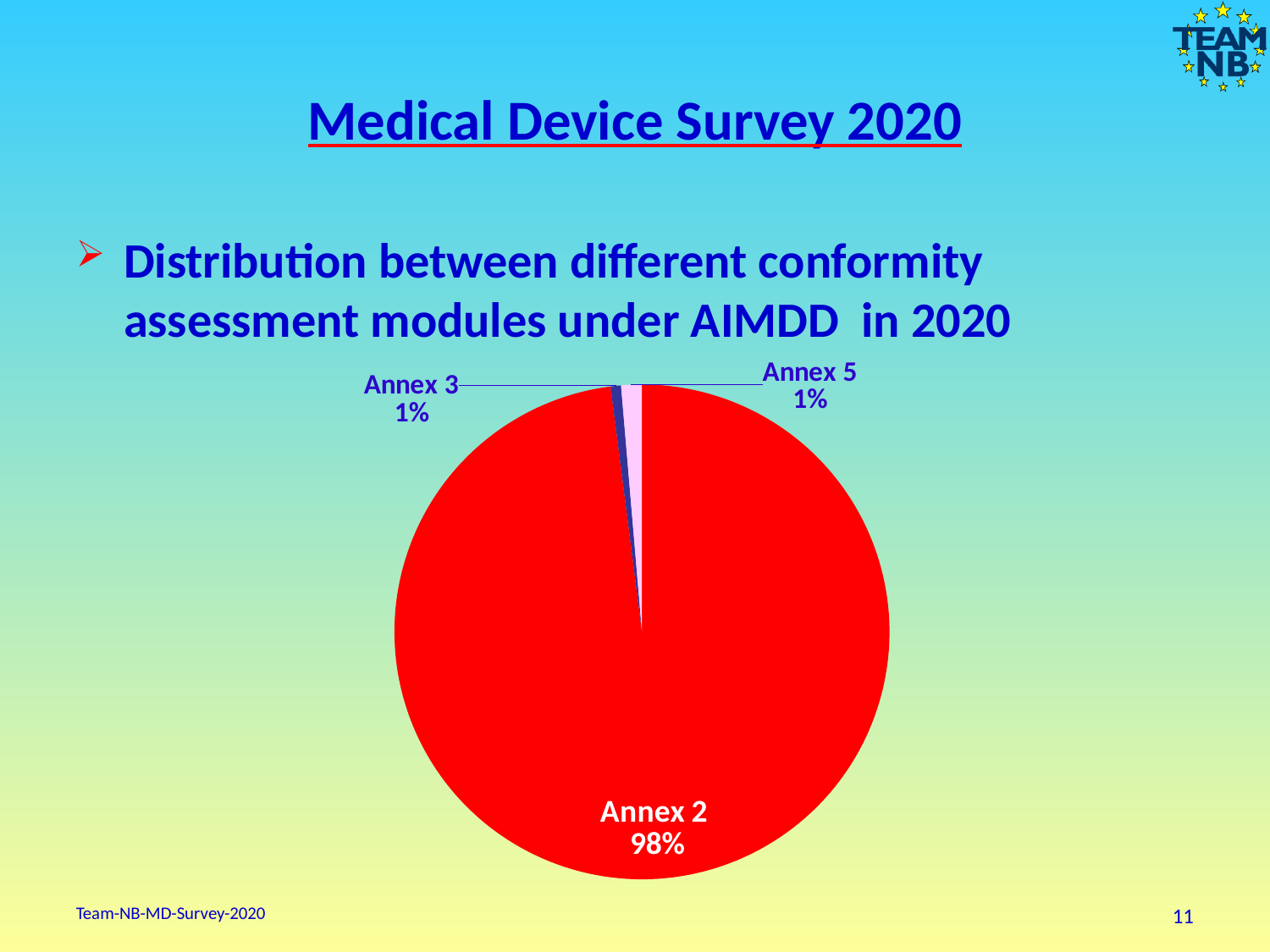
What percentage of the pie chart is Annex 3? 1% What is the difference in percentage points between Annex 2 and Annex 3 in the pie chart? 97 What colour is the Annex 2 slice in the pie chart? red Which slices of the pie chart are labelled with 1%? Annex 3 and Annex 5 What percentage of the pie chart is Annex 5? 1% What share of the pie does the Annex 2 slice take? 98% Which slice of the pie chart is the largest? Annex 2 How many slices does the pie chart have? 3 According to the slide text, what does the pie chart show the distribution of? different conformity assessment modules under AIMDD in 2020 Which is larger in the pie chart, Annex 2 or Annex 5? Annex 2 What kind of chart is shown on the slide? pie chart What percentage of the pie chart is Annex 2? 98%